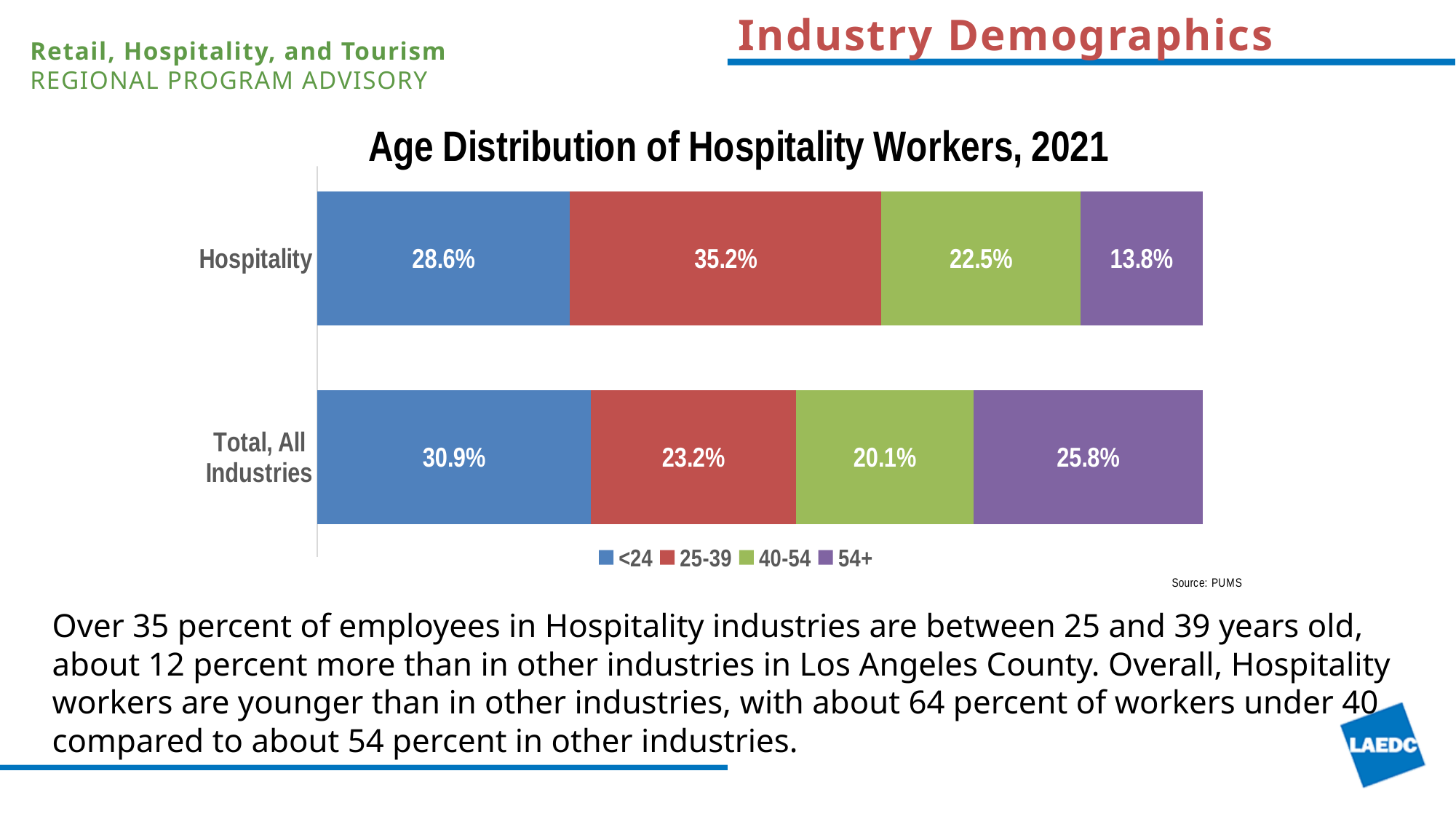
How many categories (bars) are shown in the chart? 2 What is the value for the <24 age group in the Hospitality bar? 28.6% What type of chart is shown on the slide? Stacked bar chart What is the value for the 40-54 age group in the Total, All Industries bar? 20.1% Which age group has the largest share in the Hospitality bar? 25-39 Which age group has the smallest share in the Total, All Industries bar? 40-54 How many age groups does the legend list? 4 Which age group has the smallest share in the Hospitality bar? 54+ What is the value for the 54+ age group in the Total, All Industries bar? 25.8% What is the difference between the 25-39 share for Hospitality and for Total, All Industries? 12.0% What is the value for the 25-39 age group in the Hospitality bar? 35.2% Which is larger: the 54+ share for Hospitality or for Total, All Industries? Total, All Industries